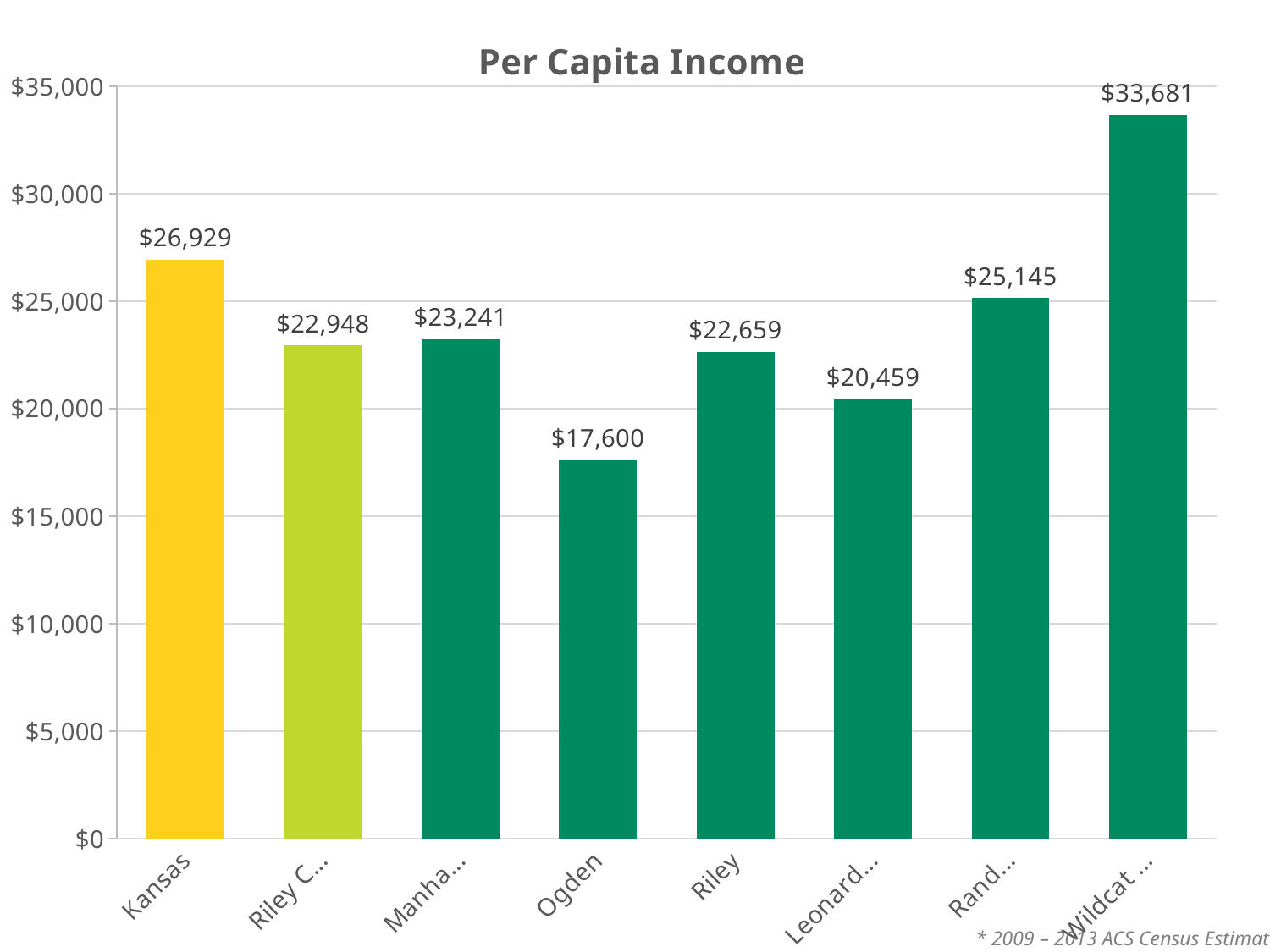
Which has a higher per capita income, Kansas or Riley? Kansas Which category has the lowest per capita income? Ogden Is the value for Ogden greater or less than $20,000? less What is the per capita income shown for Ogden? $17,600 What is the difference between the per capita income of Kansas and Ogden? $9,329 What is the per capita income shown for Riley? $22,659 How many bars are shown in the chart? 8 What is the title of the chart? Per Capita Income What is the per capita income shown for Kansas? $26,929 What type of chart is shown on the slide? bar chart Which has a higher per capita income, Ogden or Riley? Riley What is the difference between the per capita income of Kansas and Riley? $4,270